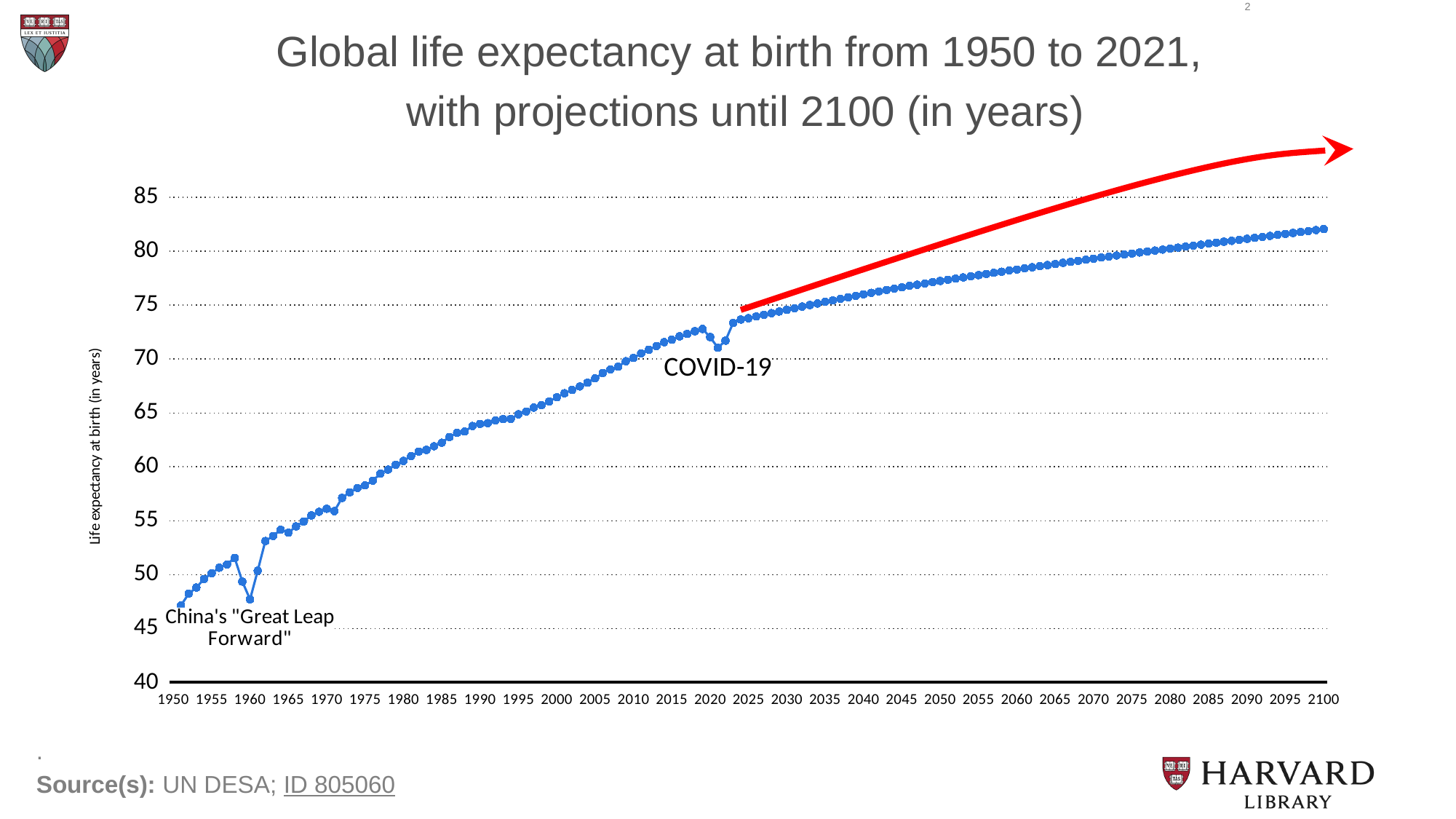
Is the life expectancy value for 1985 greater or less than 60? greater Is the life expectancy value for 2100 greater or less than 80? greater Overall, do the life expectancy values rise or fall from 1950 to 2100? rise Is the life expectancy value for 2050 greater or less than 75? greater In which year does the plotted line reach its highest value? 2100 Which event is annotated at the dip in the line around 2020? COVID-19 Which is higher, the life expectancy value for 2000 or for 1950? 2000 What kind of chart is shown on the slide? line chart What is the label on the vertical axis of the chart? Life expectancy at birth (in years)